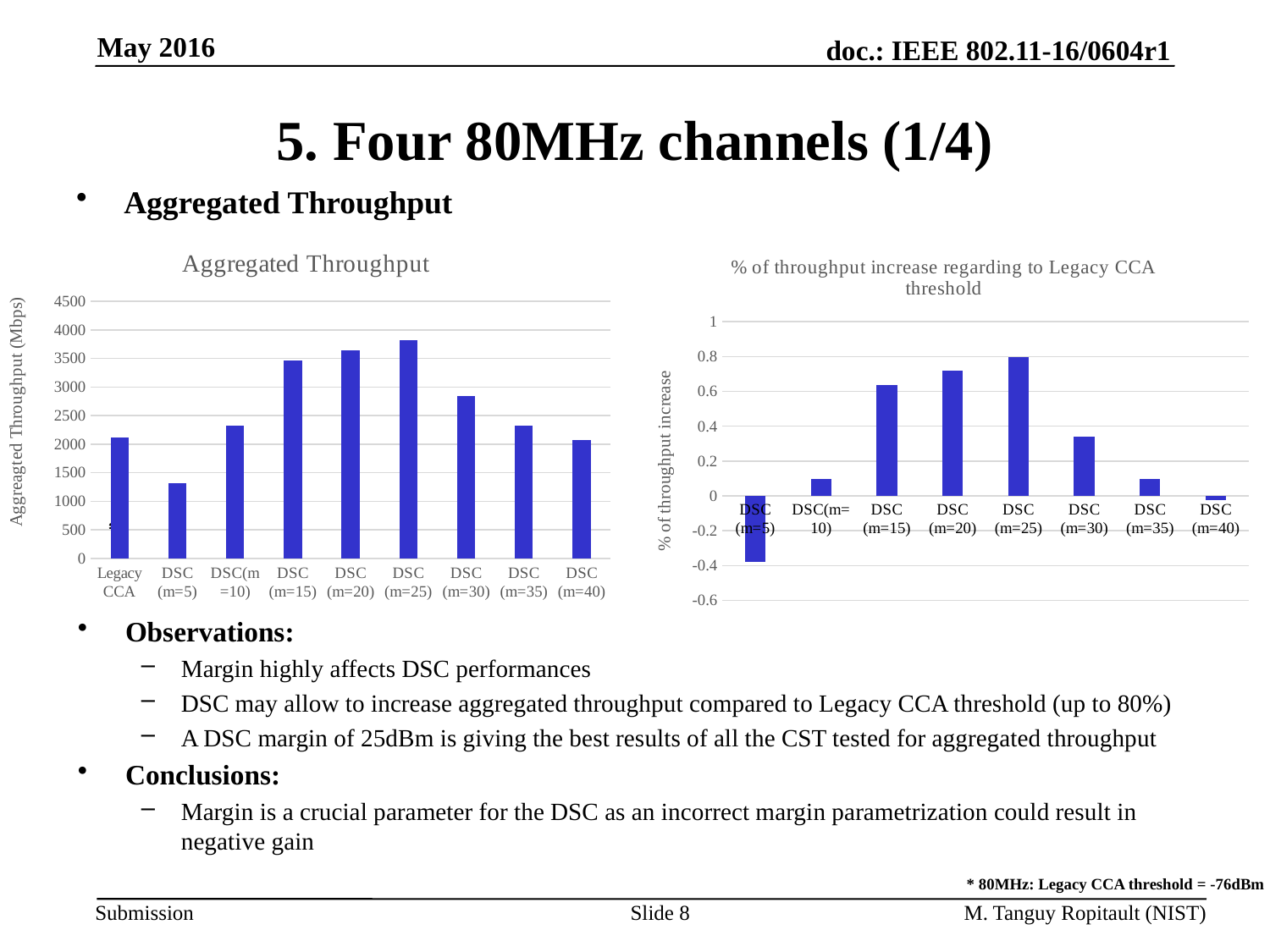
In the "% of throughput increase regarding to Legacy CCA threshold" chart, which category has the highest value? DSC (m=25) In the "Aggregated Throughput" chart, is the value for DSC (m=25) greater or less than 3500? greater In the "% of throughput increase regarding to Legacy CCA threshold" chart, is the value for DSC (m=5) greater or less than 0? less In the "Aggregated Throughput" chart, which is larger, the value for DSC (m=20) or DSC (m=30)? DSC (m=20) In the "Aggregated Throughput" chart, is the value for DSC (m=5) greater or less than 1500? less In the "% of throughput increase regarding to Legacy CCA threshold" chart, how many categories are plotted? 8 In the "Aggregated Throughput" chart, which category has the highest aggregated throughput? DSC (m=25) What kind of chart is the "Aggregated Throughput" chart on the left? bar chart In the "% of throughput increase regarding to Legacy CCA threshold" chart, which category has the lowest value? DSC (m=5) What is the y-axis label of the "Aggregated Throughput" chart? Aggreagted Throughput (Mbps) In the "Aggregated Throughput" chart, which category has the lowest aggregated throughput? DSC (m=5) In the "Aggregated Throughput" chart, how many categories are plotted? 9